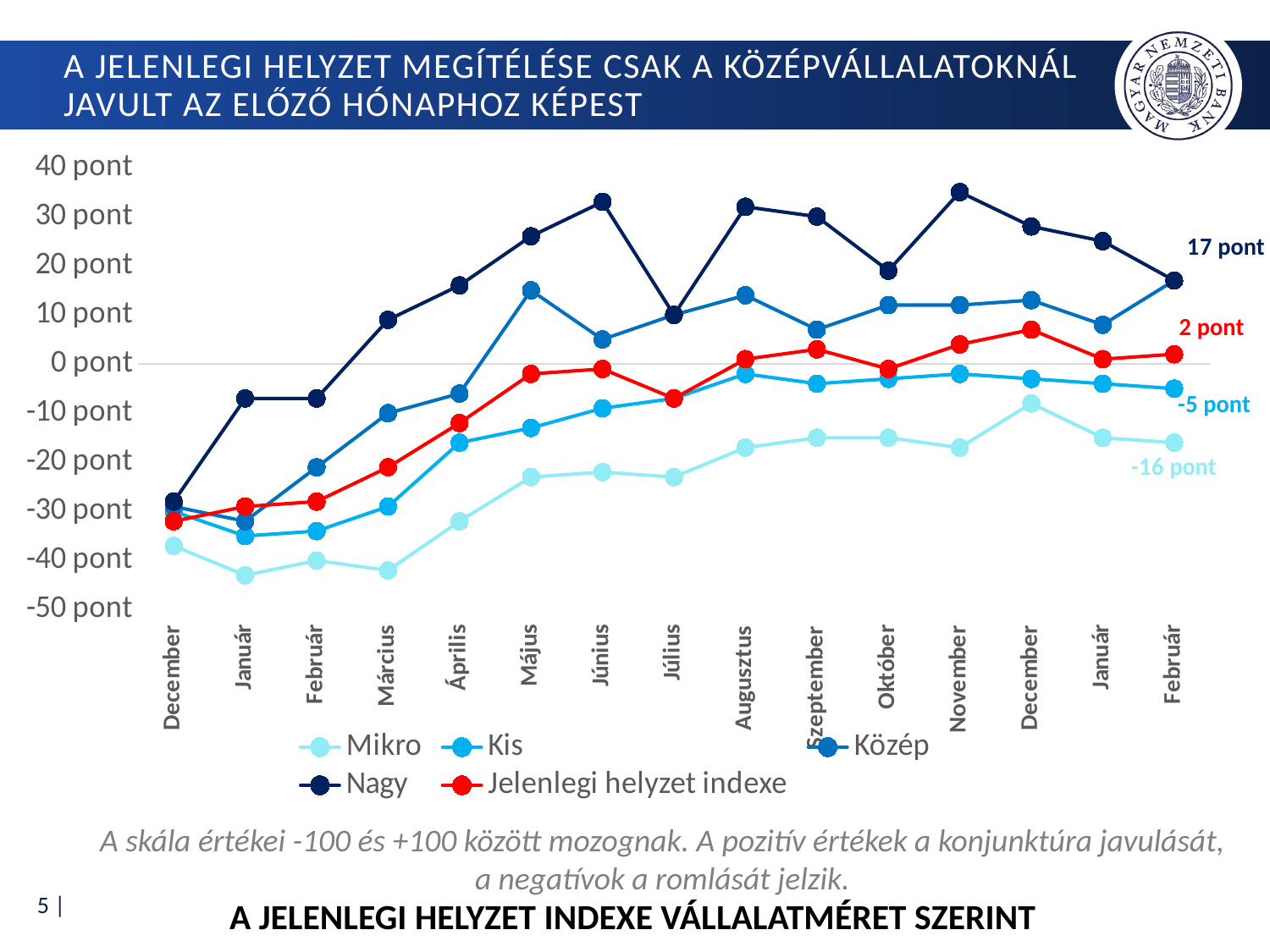
Which series has the lowest value in the final Február? Mikro What is the value of Jelenlegi helyzet indexe in the final Február? 2 pont How many series does the legend list? 5 In the final Február, which is larger: the Mikro value or the Kis value? Kis Which series has the highest value in Május? Nagy Is the value for Nagy in Június greater or less than 30 pont? greater In the final Február, what is the difference between the Kis value and the Mikro value? 11 pont How many months are shown along the x axis? 15 What is the title of the chart shown at the bottom of the slide? A JELENLEGI HELYZET INDEXE VÁLLALATMÉRET SZERINT What is the value of the Mikro series in the final Február? -16 pont What kind of chart is shown on the slide? line chart What is the value of the Kis series in the final Február? -5 pont